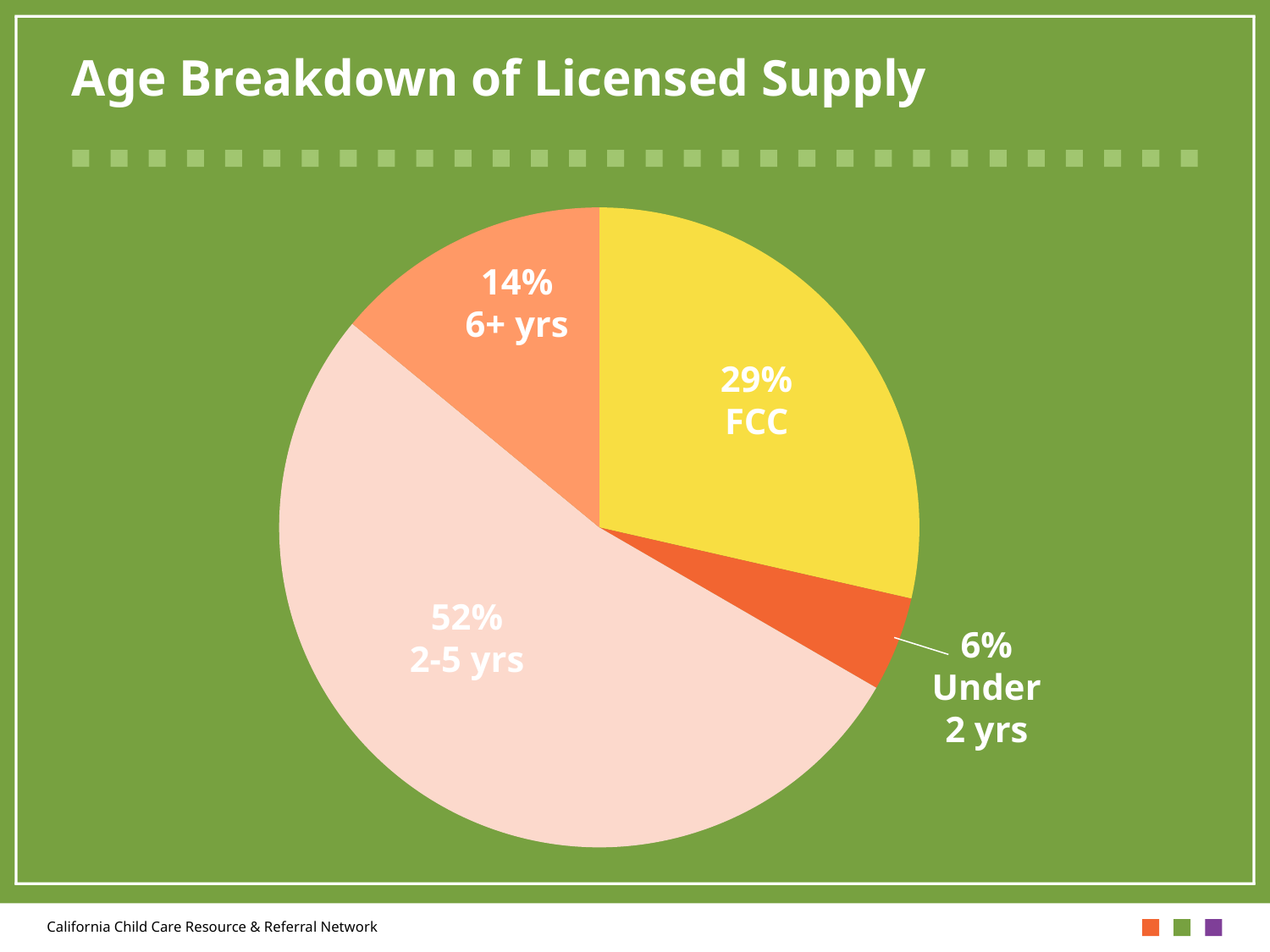
Which slice of the pie is the smallest? Under 2 yrs What kind of chart is shown on the slide? pie chart What is the difference in percentage points between the 2-5 yrs slice and the FCC slice? 23 Which slice of the pie is the largest? 2-5 yrs What share of the pie is labelled 2-5 yrs? 52% What share of the pie is labelled Under 2 yrs? 6% What share of the pie is labelled 6+ yrs? 14% How many slices does the pie chart have? 4 What colour is the FCC slice? yellow Which is larger, the 6+ yrs slice or the Under 2 yrs slice? 6+ yrs What is the title of the chart? Age Breakdown of Licensed Supply